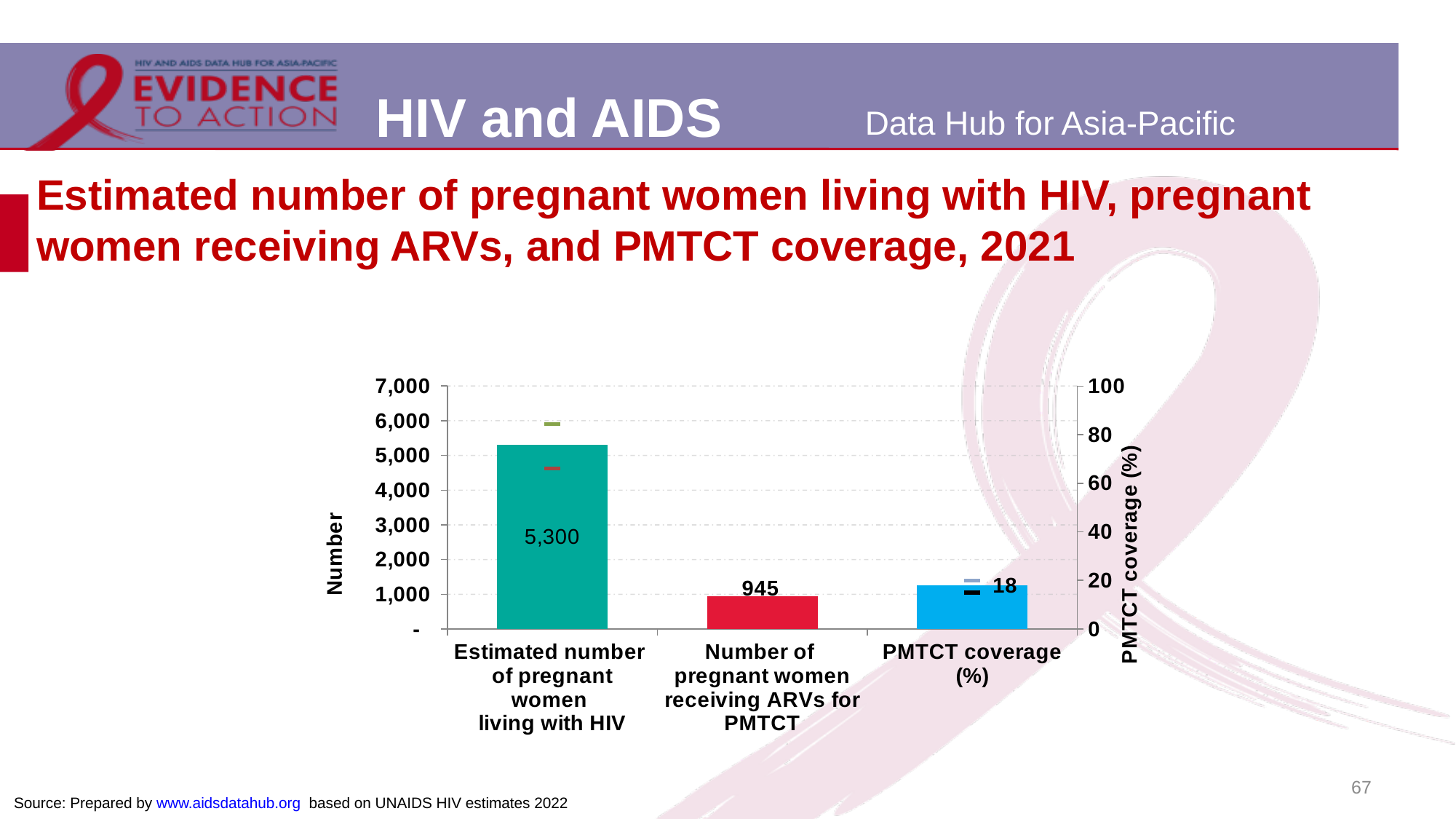
Is the PMTCT coverage (%) greater or less than 20 on the right-hand axis? less Which category has the tallest bar on the chart? Estimated number of pregnant women living with HIV What is the estimated number of pregnant women living with HIV shown on the chart? 5,300 What is the PMTCT coverage (%) value shown on the chart? 18 Which is larger: the estimated number of pregnant women living with HIV or the number of pregnant women receiving ARVs for PMTCT? Estimated number of pregnant women living with HIV What is the difference between the estimated number of pregnant women living with HIV and the number of pregnant women receiving ARVs for PMTCT? 4,355 What is the label of the left-hand vertical axis? Number What is the label of the right-hand vertical axis? PMTCT coverage (%) What is the number of pregnant women receiving ARVs for PMTCT shown on the chart? 945 Is the number of pregnant women receiving ARVs for PMTCT greater or less than 1,000? less How many bars are plotted on the chart? 3 What kind of chart is shown on the slide? Bar chart